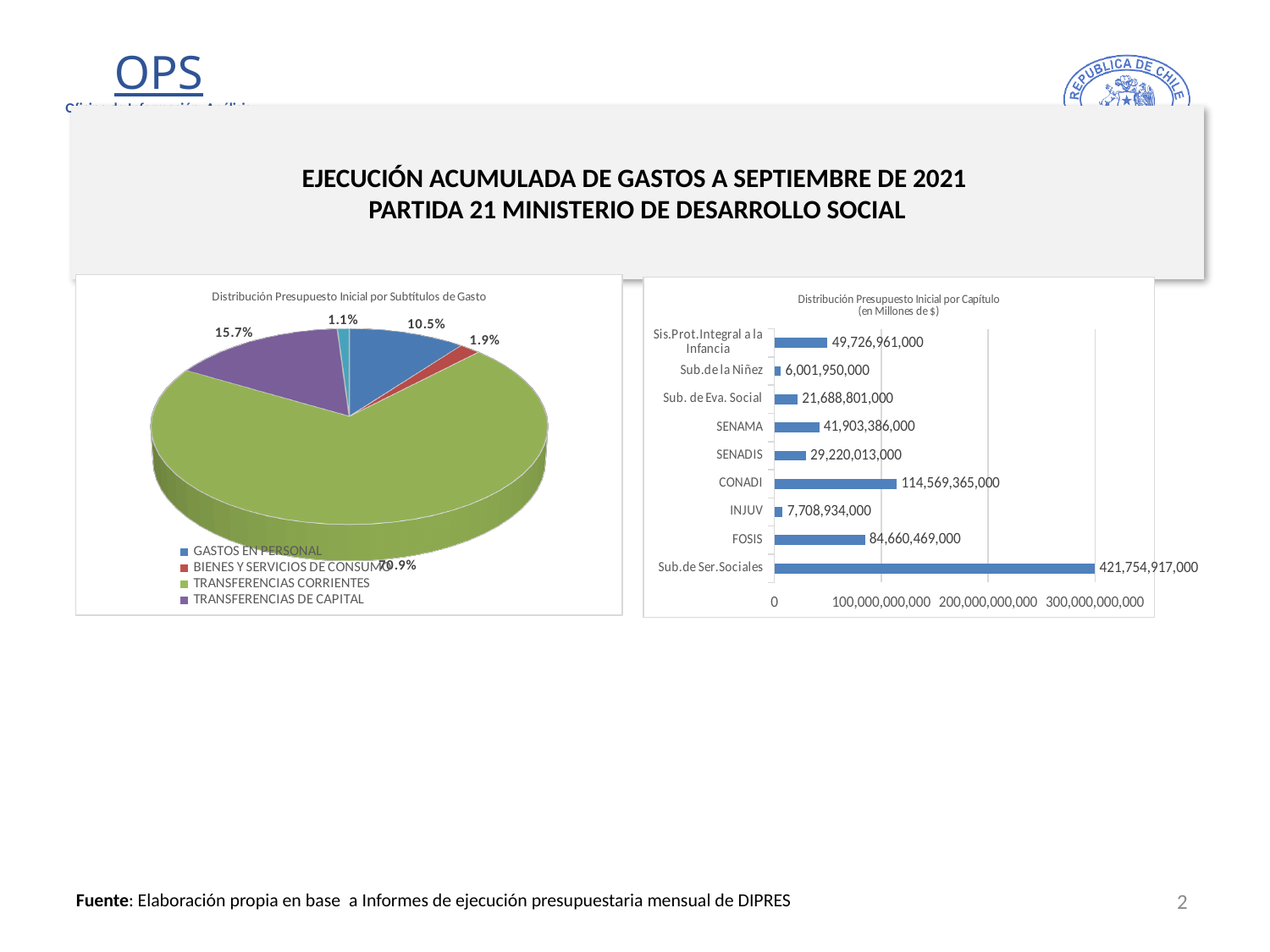
In the bar chart on the right, which is larger, the value for SENAMA or the value for SENADIS? SENAMA In the bar chart on the right, what is the value for FOSIS? 84,660,469,000 In the bar chart on the right, which category has the lowest value? Sub.de la Niñez In the bar chart on the right, which category has the highest value? Sub.de Ser.Sociales In the pie chart on the left, what share does TRANSFERENCIAS CORRIENTES have? 70.9% In the bar chart on the right, what is the value for CONADI? 114,569,365,000 How many categories are shown in the bar chart on the right? 9 In the bar chart on the right, what is the difference between the values for CONADI and FOSIS? 29,908,896,000 How many entries does the legend of the pie chart on the left list? 4 In the pie chart on the left, what share does TRANSFERENCIAS DE CAPITAL have? 15.7% In the bar chart on the right, is the value for CONADI greater or less than 100,000,000,000? greater What kind of chart is the chart on the right? bar chart